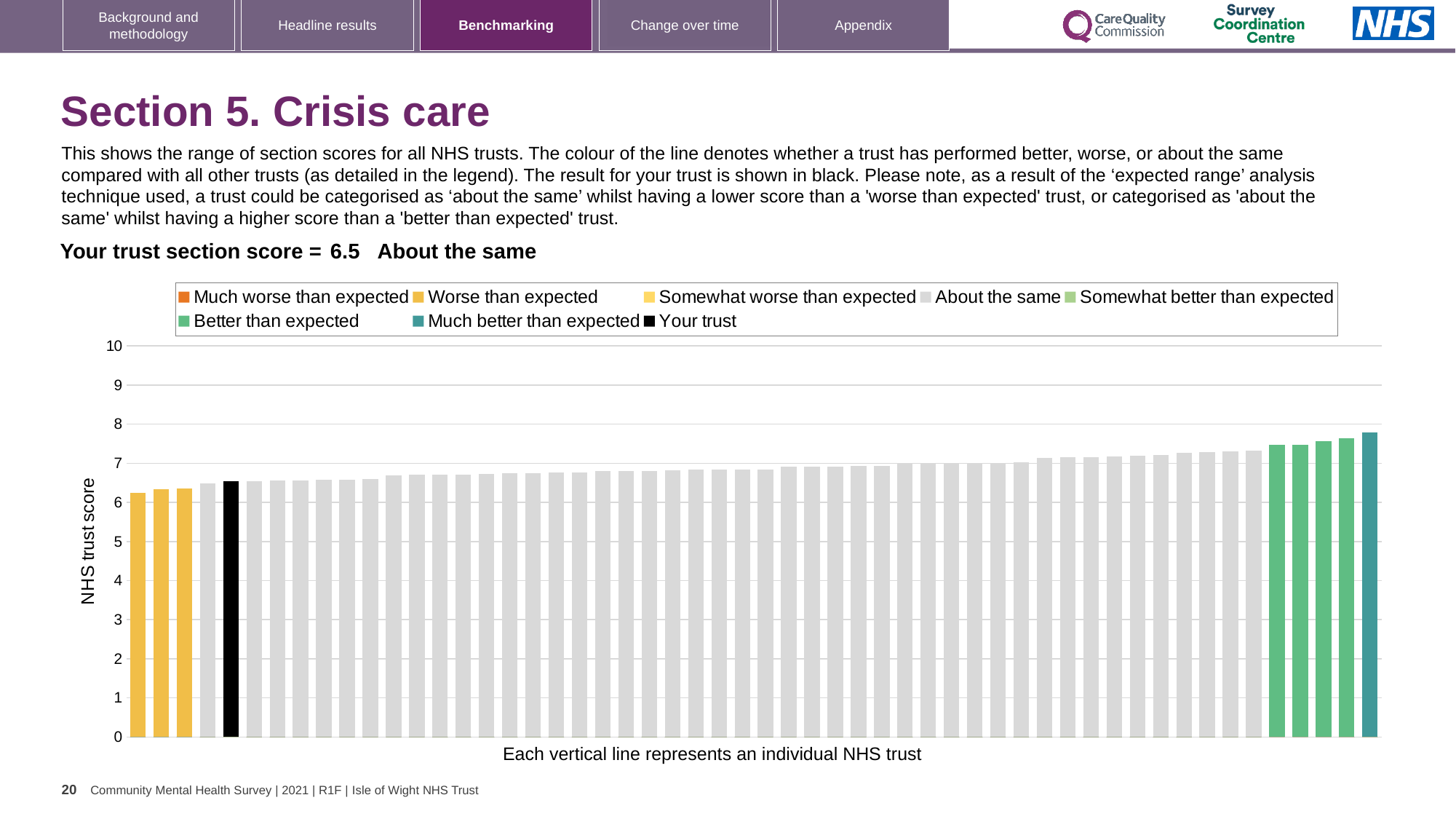
Which performance category does your trust fall into for crisis care? About the same Is the value for your trust (the black bar) greater or less than 6? greater What is the section score for your trust shown on the slide? 6.5 What kind of chart is shown on the slide? bar chart Do the bar values rise or fall moving from left to right along the x axis? rise Which legend category do the shortest bars belong to? Worse than expected How many bars are coloured as 'Worse than expected'? 3 Is the shortest bar on the chart greater or less than 7? less Is the tallest bar on the chart greater or less than 8? less How many entries does the chart legend list? 8 What is the label on the y axis of the chart? NHS trust score Which legend category does the tallest bar belong to? Much better than expected